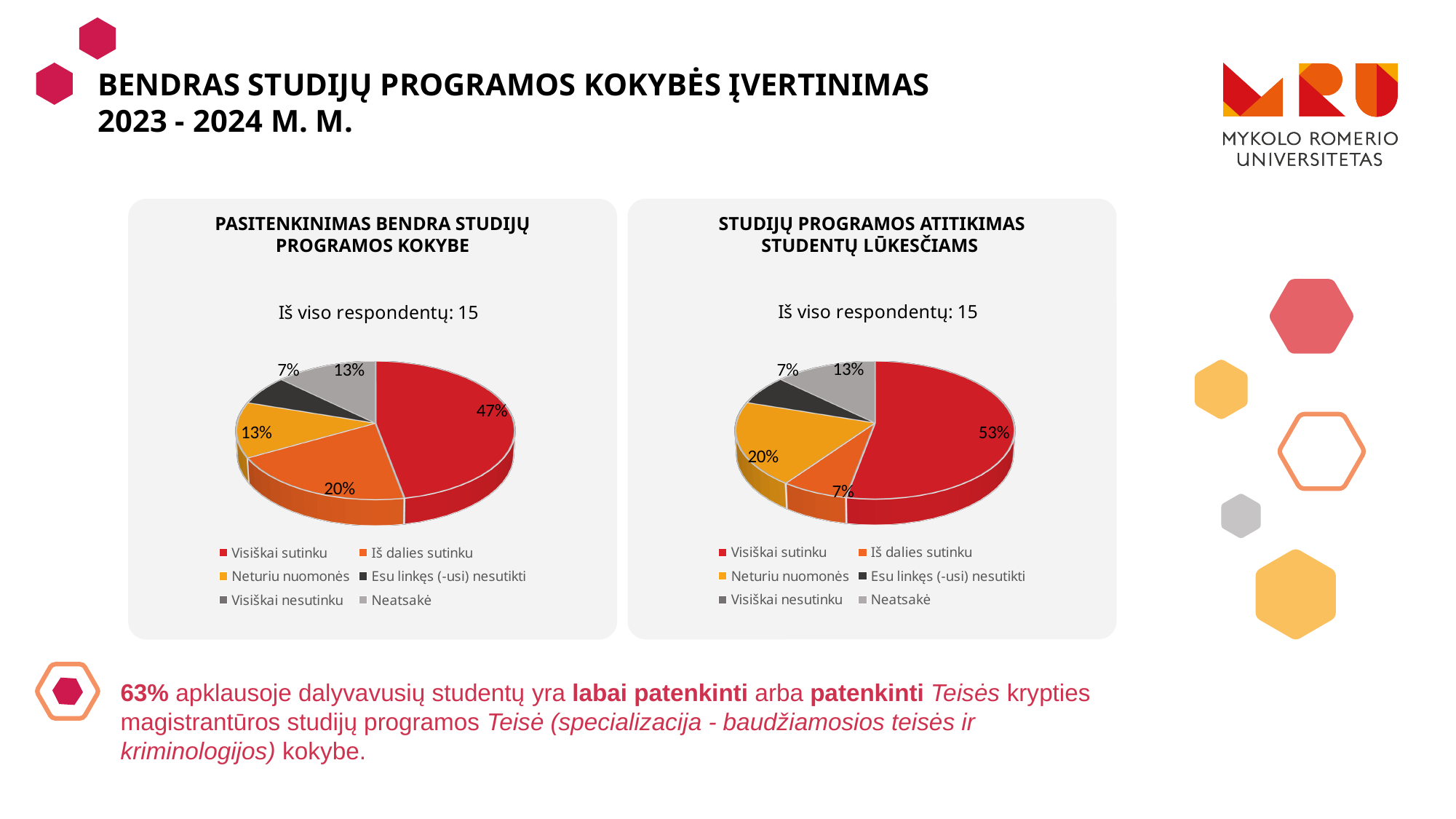
Which chart shows a larger share for "Visiškai sutinku", the left one or the right one? The right chart (53%) What type of chart is used on this slide? Pie chart In the right chart (Studijų programos atitikimas studentų lūkesčiams), which response has the largest share? Visiškai sutinku In the right chart (Studijų programos atitikimas studentų lūkesčiams), what share of respondents answered "Neturiu nuomonės"? 20% In the left chart (Pasitenkinimas bendra studijų programos kokybe), what is the difference in percentage points between "Visiškai sutinku" and "Iš dalies sutinku"? 27 percentage points In the left chart (Pasitenkinimas bendra studijų programos kokybe), what share of respondents answered "Iš dalies sutinku"? 20% In the right chart (Studijų programos atitikimas studentų lūkesčiams), what share of respondents answered "Neatsakė"? 13% In the left chart (Pasitenkinimas bendra studijų programos kokybe), what share of respondents answered "Visiškai sutinku"? 47% In the right chart (Studijų programos atitikimas studentų lūkesčiams), what share of respondents answered "Visiškai sutinku"? 53% How many entries does the legend of the left chart (Pasitenkinimas bendra studijų programos kokybe) list? 6 In the left chart (Pasitenkinimas bendra studijų programos kokybe), which response has the largest share? Visiškai sutinku How many respondents in total does the right chart (Studijų programos atitikimas studentų lūkesčiams) report? 15